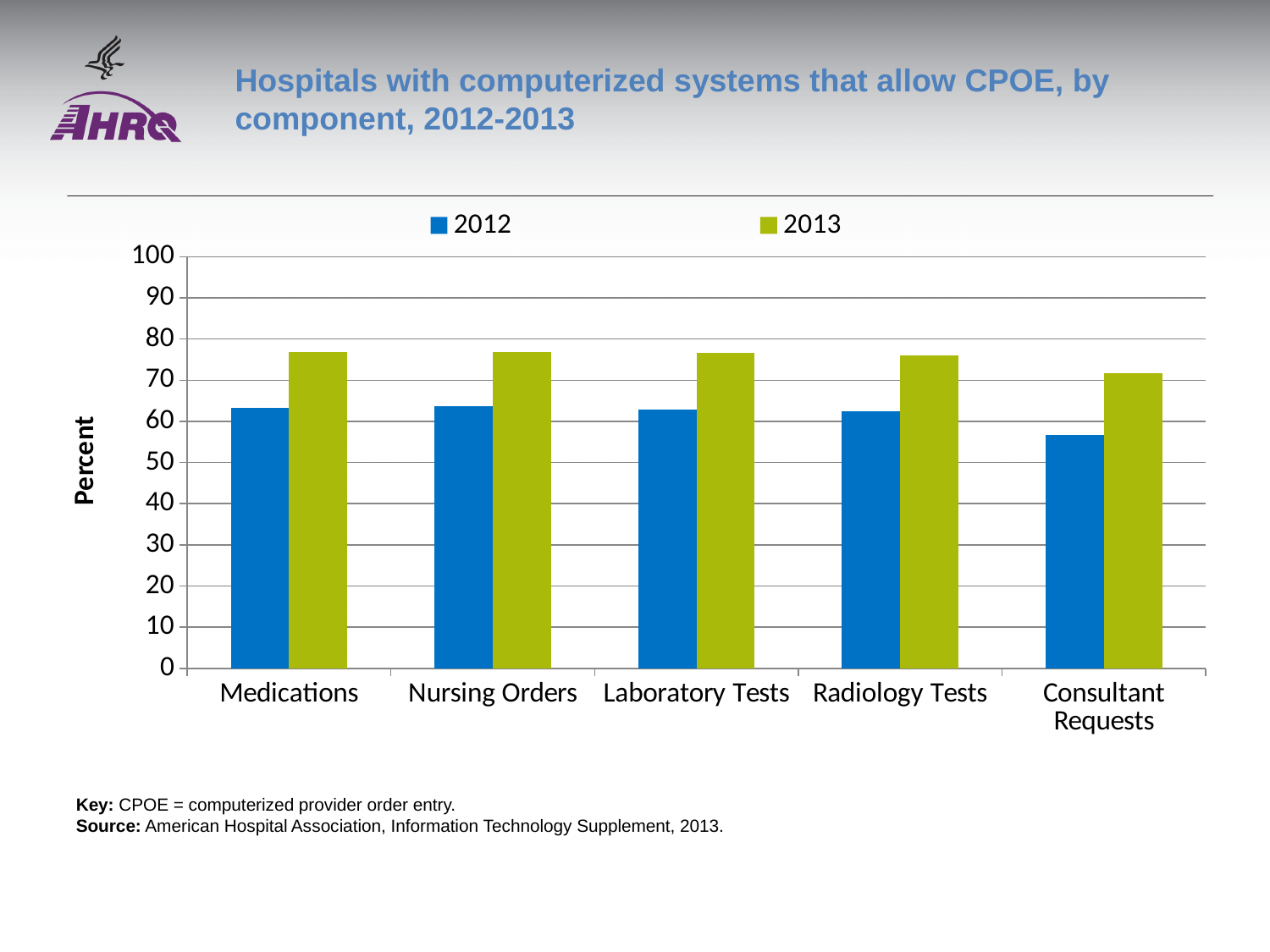
What is the label on the y axis? Percent What kind of chart is shown on the slide? bar chart Which component has the lowest value for 2012? Consultant Requests Is the 2012 value for Medications greater or less than 60? greater How many series does the legend list? 2 Is the 2013 value for Radiology Tests greater or less than 70? greater For Consultant Requests, which year has the larger value, 2012 or 2013? 2013 Is the 2012 value for Consultant Requests greater or less than 60? less For Medications, which year has the larger value, 2012 or 2013? 2013 How many component categories are shown on the x axis? 5 Which component has the lowest value for 2013? Consultant Requests